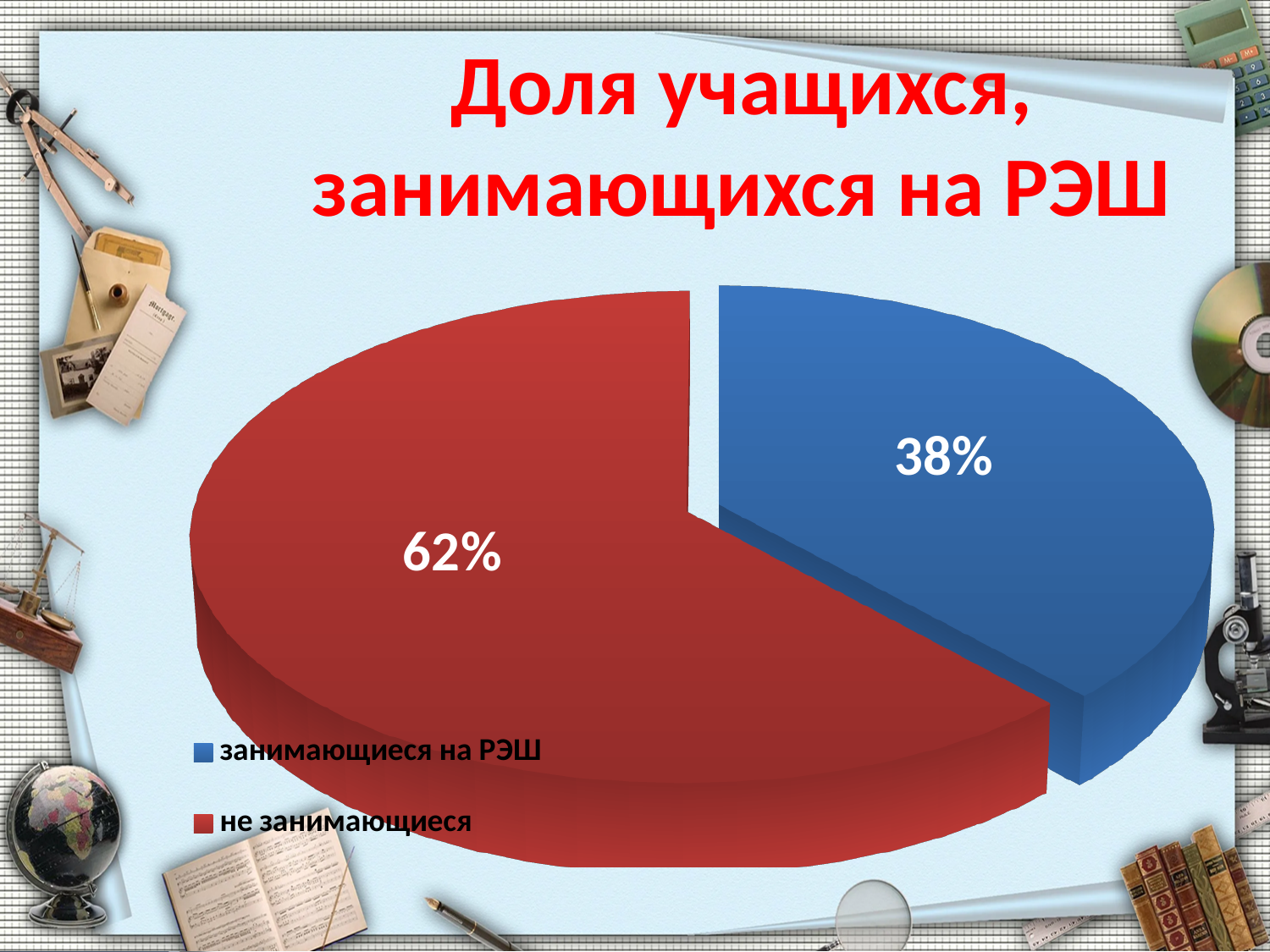
Which slice of the pie is the largest? не занимающиеся What share of the pie is labelled "не занимающиеся"? 62% What is the title of the chart? Доля учащихся, занимающихся на РЭШ How many slices does the pie chart have? 2 What colour is the slice for "занимающиеся на РЭШ"? blue How many entries does the legend list? 2 What share of the pie is labelled "занимающиеся на РЭШ"? 38% What is the difference in percentage points between the "не занимающиеся" slice and the "занимающиеся на РЭШ" slice? 24 Which is larger: the share for "занимающиеся на РЭШ" or the share for "не занимающиеся"? не занимающиеся Which slice of the pie is the smallest? занимающиеся на РЭШ What kind of chart is shown on the slide? pie chart